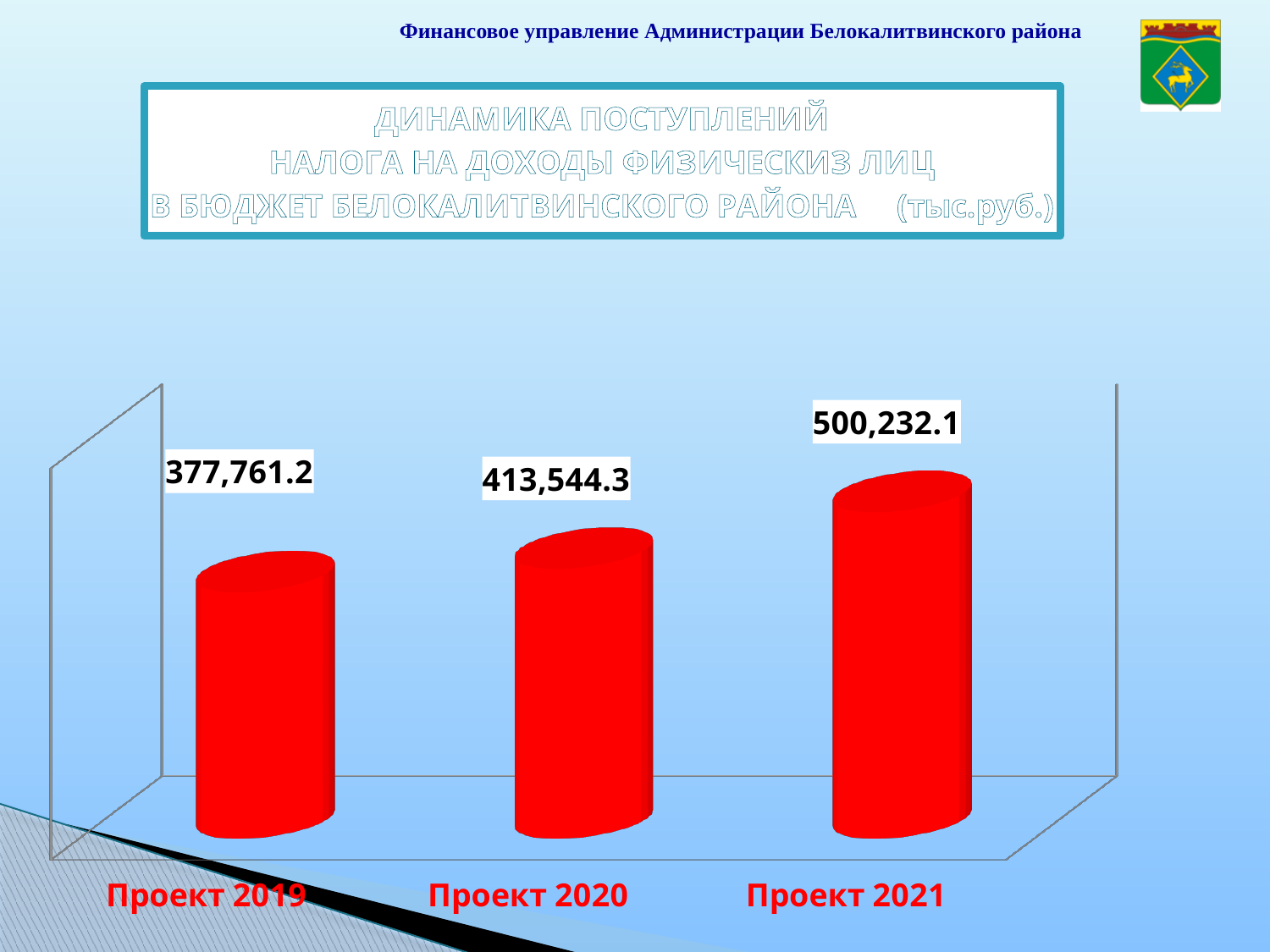
What is the difference between the values for Проект 2021 and Проект 2020? 86,687.8 Which category has the lowest value? Проект 2019 What is the value for Проект 2020? 413,544.3 What kind of chart is shown on the slide? Bar chart What is the difference between the values for Проект 2021 and Проект 2019? 122,470.9 Do the values rise or fall from Проект 2019 to Проект 2021? Rise How many categories are shown in the chart? 3 What is the value for Проект 2019? 377,761.2 Which is larger, the value for Проект 2020 or the value for Проект 2019? Проект 2020 What is the difference between the values for Проект 2020 and Проект 2019? 35,783.1 What is the value for Проект 2021? 500,232.1 Which category has the highest value? Проект 2021